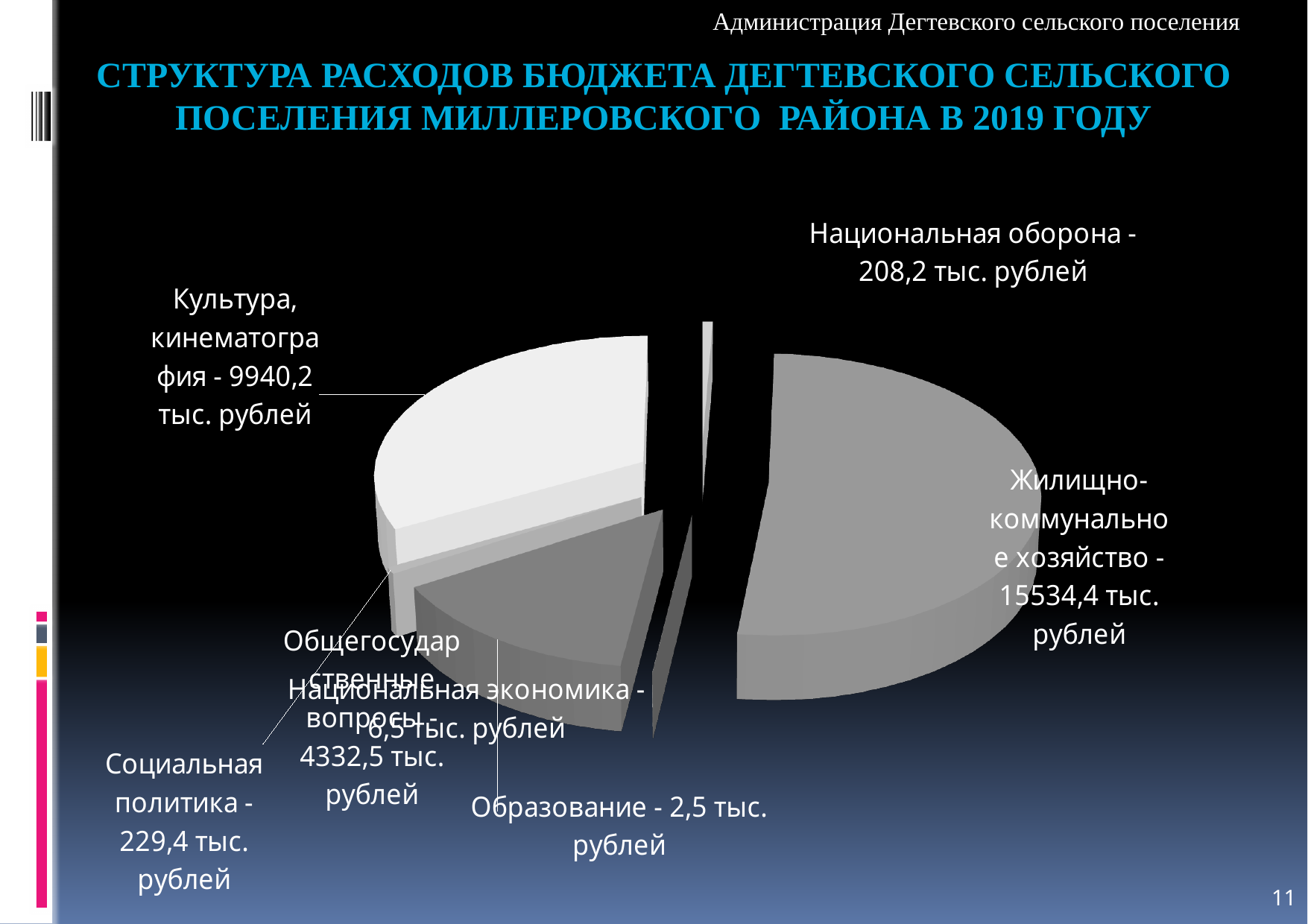
What is the value for Культура, кинематография? 9940,2 тыс. рублей What is the difference between Жилищно-коммунальное хозяйство and Культура, кинематография? 5594,2 тыс. рублей What kind of chart is shown on the slide? Pie chart Which is larger: Социальная политика or Национальная оборона? Социальная политика What is the value for Национальная оборона? 208,2 тыс. рублей What is the value for Жилищно-коммунальное хозяйство? 15534,4 тыс. рублей What is the value for Социальная политика? 229,4 тыс. рублей What is the value for Общегосударственные вопросы? 4332,5 тыс. рублей What is the value for Образование? 2,5 тыс. рублей Which expenditure category has the largest value? Жилищно-коммунальное хозяйство Which expenditure category has the smallest value? Образование How many expenditure categories are shown in the pie chart? 7